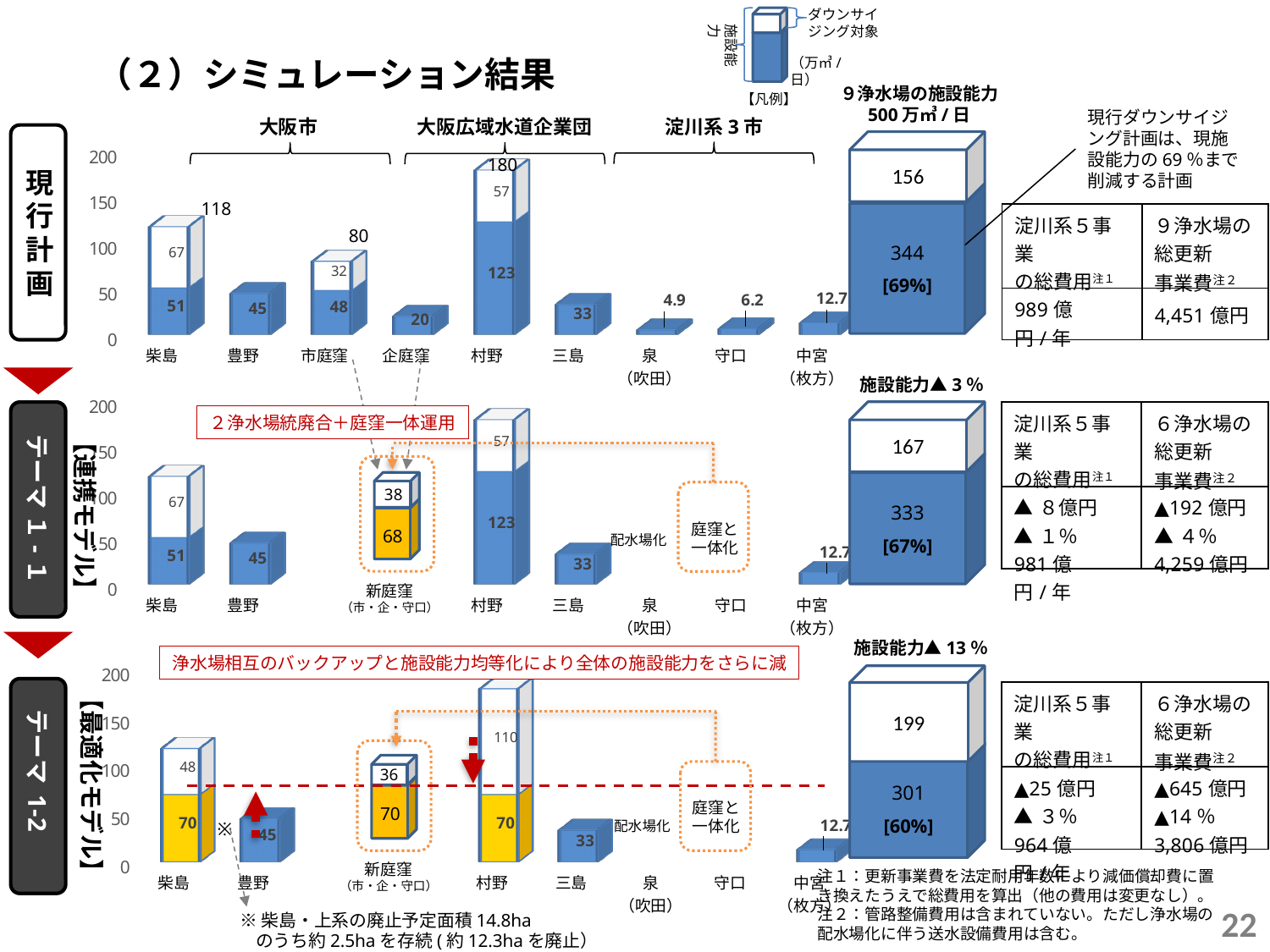
In the bottom chart (テーマ1-2), what is the yellow (lower) value shown for 村野? 70 In the middle chart (テーマ1-1), what is the blue (lower) value shown for 新庭窪? 68 In the top chart (現行計画), how many treatment plant categories are shown on the x axis? 9 In the top chart (現行計画), what is the value shown for 豊野? 45 In the top chart (現行計画), which category has the lowest value? 泉（吹田） In the top chart (現行計画), what total value is printed above the 柴島 bar? 118 In the top chart (現行計画), what is the difference between the total for 村野 (180) and the total for 柴島 (118)? 62 In the top chart (現行計画), which is larger, the value for 泉（吹田） or for 守口? 守口 In the bottom chart (テーマ1-2), what is the total of the 新庭窪 stacked bar (70 + 36)? 106 What kind of chart is used in each of the three rows of this slide? Bar chart In the middle chart (テーマ1-1), what percentage is printed on the large bar on the right? 67% In the top chart (現行計画), which category has the highest bar? 村野